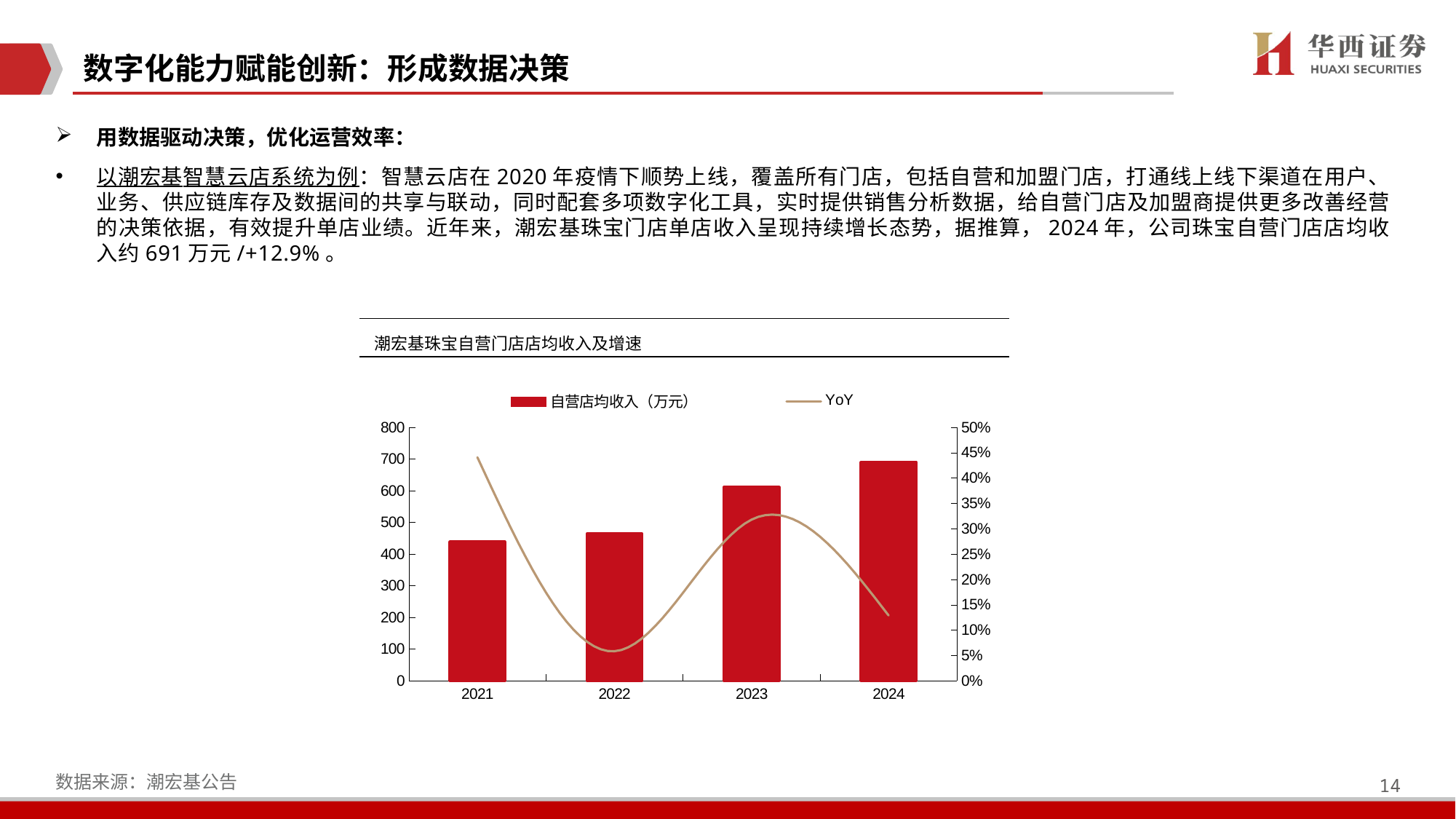
How many series does the chart legend list? 2 How many years are shown on the x axis of the chart? 4 Which year has the highest bar for 自营店均收入（万元）? 2024 Is the YoY value for 2022 greater or less than 10%? less Is the 自营店均收入（万元） value for 2021 greater or less than 500? less Which year has the larger 自营店均收入（万元） bar, 2022 or 2023? 2023 Which year has the highest YoY value on the line? 2021 What kind of chart is shown on the slide? A combined bar and line chart Which year has the lowest YoY value on the line? 2022 Do the 自营店均收入（万元） bars rise or fall from 2021 to 2024? Rise Which year has the lowest bar for 自营店均收入（万元）? 2021 What is the title of the chart? 潮宏基珠宝自营门店店均收入及增速